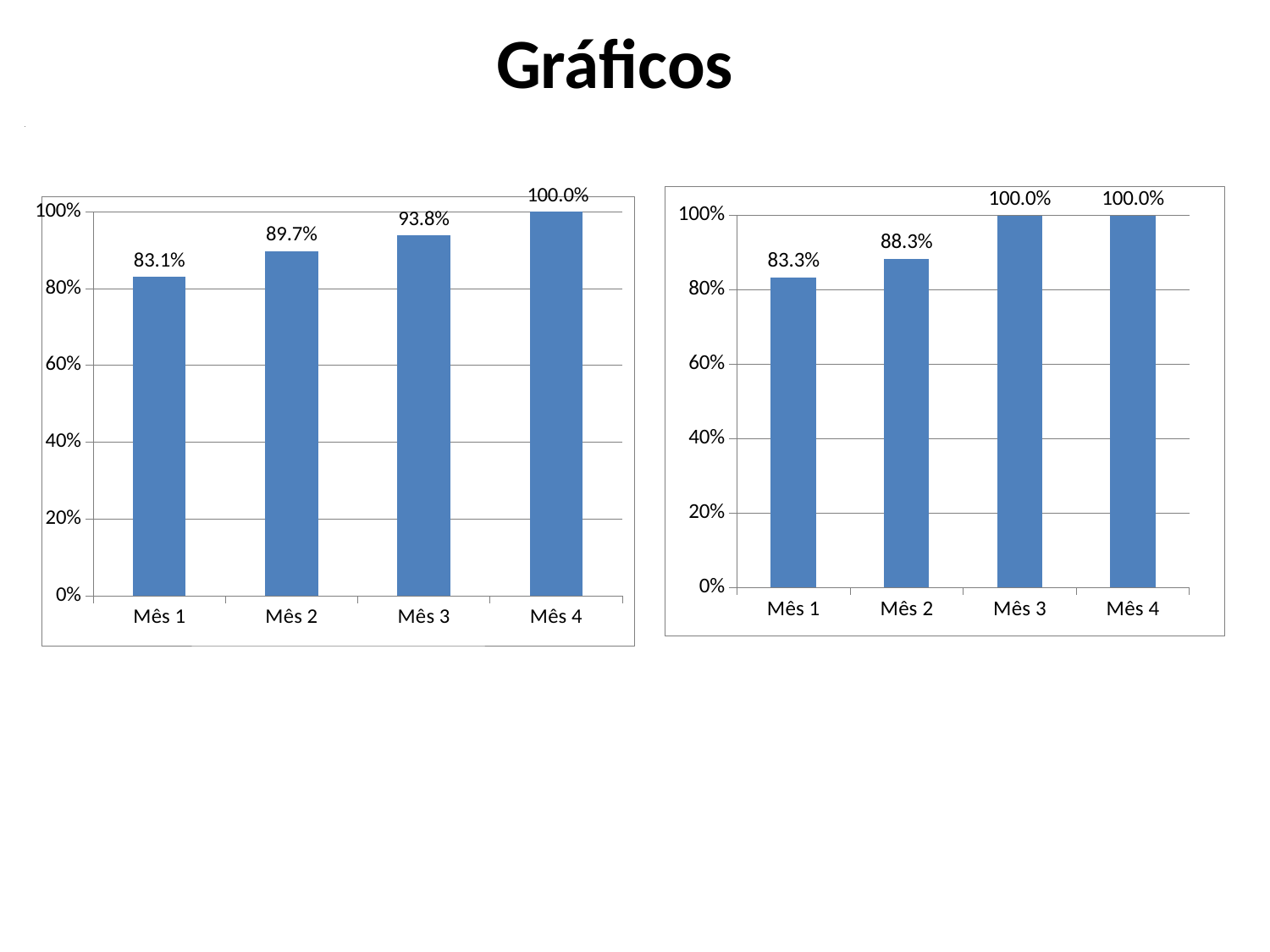
In the right chart, what is the value for Mês 2? 88.3% In the left chart, what is the difference between the values for Mês 4 and Mês 1? 16.9% In the right chart, which month has the lowest value? Mês 1 In the left chart, which month has the highest value? Mês 4 In the right chart, what is the value for Mês 1? 83.3% Do the values in the left chart rise or fall from Mês 1 to Mês 4? rise In the right chart, what is the difference between the values for Mês 2 and Mês 1? 5.0% In the left chart, what is the value for Mês 1? 83.1% In the left chart, what is the value for Mês 3? 93.8% In the left chart, which month has the lowest value? Mês 1 How many months are shown on the x axis of the right chart? 4 In the left chart, which is larger, the value for Mês 2 or the value for Mês 3? Mês 3